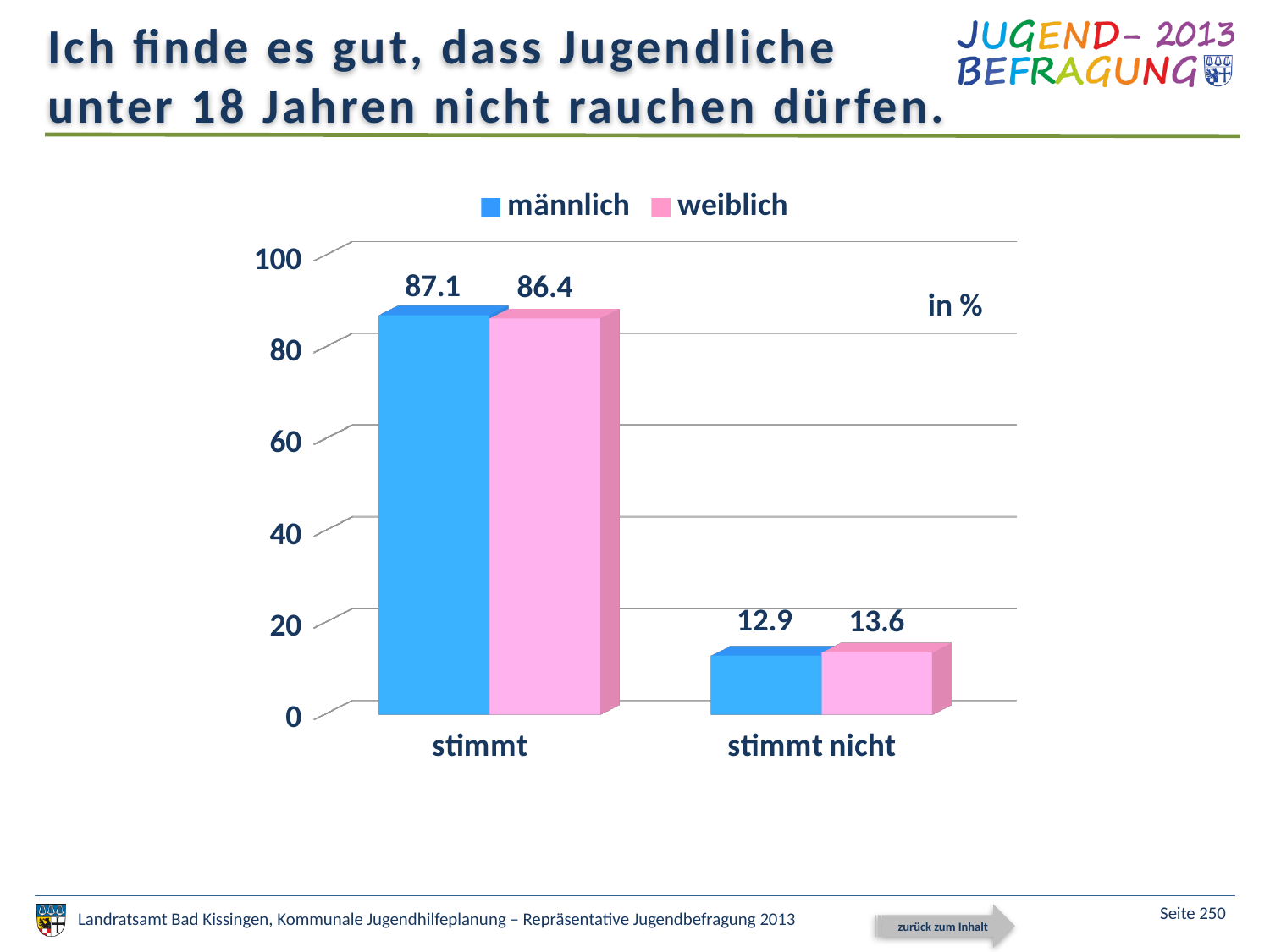
What is the value for weiblich in the stimmt nicht category? 13.6 Which category has the lowest value for weiblich? stimmt nicht What is the difference between the weiblich and männlich values in the stimmt nicht category? 0.7 What is the value for weiblich in the stimmt category? 86.4 How many series does the legend list? 2 What kind of chart is shown on the slide? bar chart Which category has the highest value for männlich? stimmt How many categories are shown on the x axis? 2 What is the value for männlich in the stimmt category? 87.1 Which is larger: the männlich value for stimmt or the männlich value for stimmt nicht? stimmt What is the value for männlich in the stimmt nicht category? 12.9 What is the difference between the männlich and weiblich values in the stimmt category? 0.7